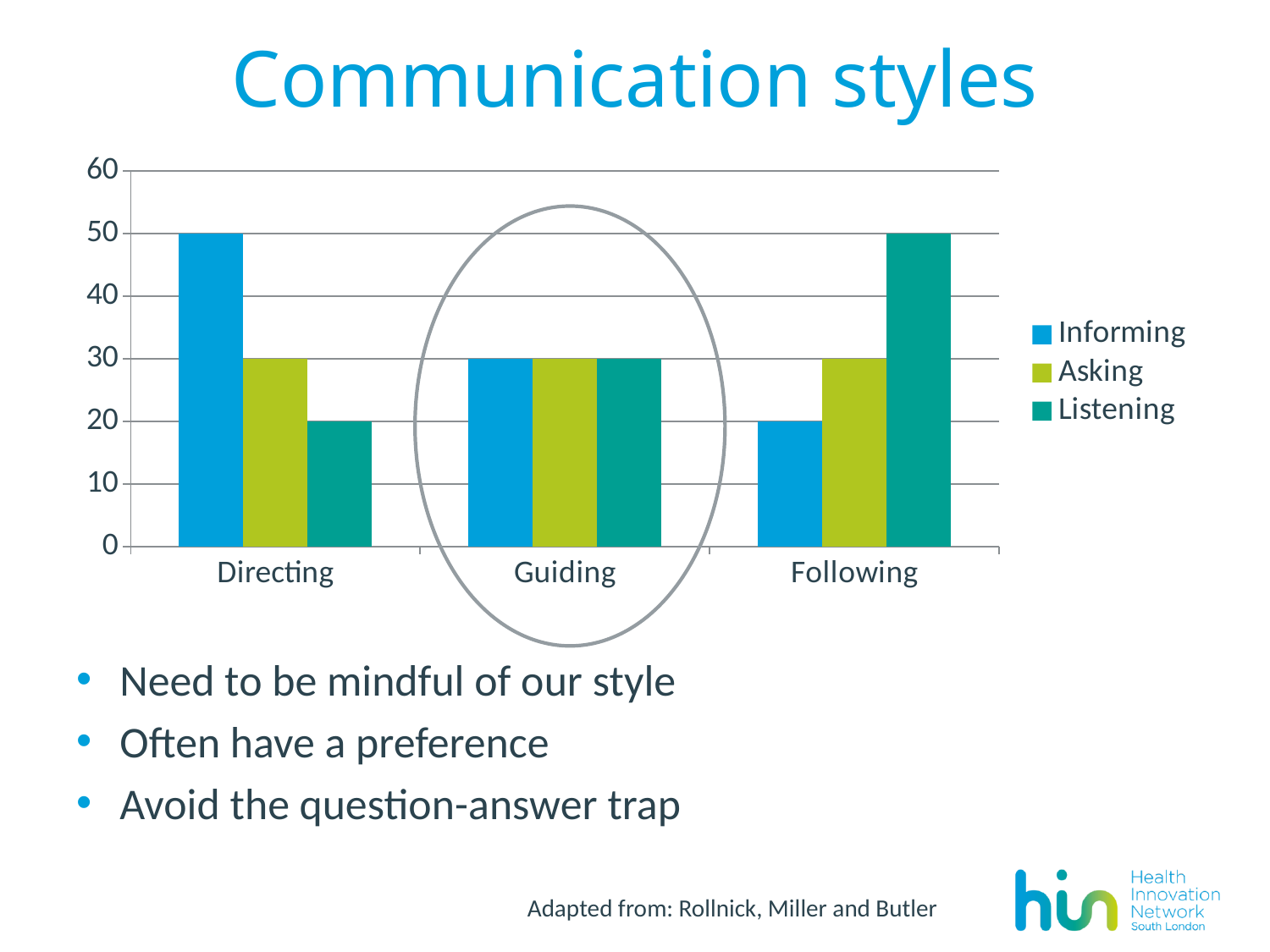
How many series does the legend list? 3 Which series has the lowest value in the Directing category? Listening Which is larger: Informing for Directing or Informing for Guiding? Informing for Directing Which series has the highest value in the Following category? Listening What is the value for Informing in the Directing category? 50 What is the difference between the Informing value for Directing and the Informing value for Following? 30 What is the value for Listening in the Following category? 50 What is the value for Asking in the Guiding category? 30 What kind of chart is shown on the slide? bar chart What is the value for Listening in the Directing category? 20 How many categories are shown on the x axis? 3 Which category on the x axis is circled on the slide? Guiding